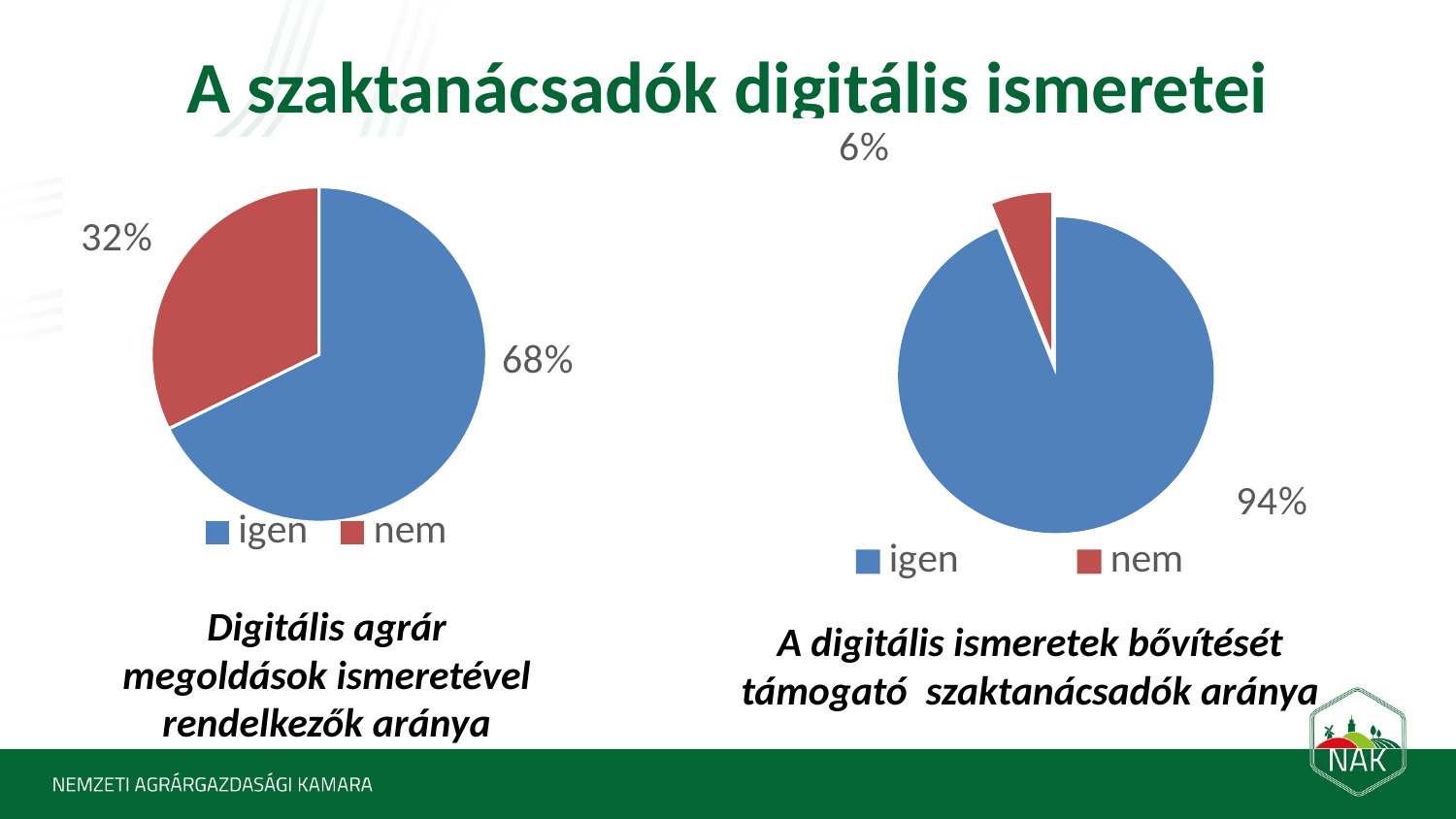
What colour represents 'nem' in the legends of both charts? red In the left pie chart, which category has the largest slice? igen What type of chart is used on the left side of the slide? pie chart In the right pie chart, which category has the smallest slice? nem In the left pie chart (Digitális agrár megoldások ismeretével rendelkezők aránya), what share is labelled for 'igen'? 68% In the left pie chart, what is the difference in percentage points between 'igen' and 'nem'? 36 In the left pie chart (Digitális agrár megoldások ismeretével rendelkezők aránya), what share is labelled for 'nem'? 32% In the right pie chart (A digitális ismeretek bővítését támogató szaktanácsadók aránya), what share is labelled for 'igen'? 94% In the right pie chart, what is the difference in percentage points between 'igen' and 'nem'? 88 In the right pie chart (A digitális ismeretek bővítését támogató szaktanácsadók aránya), what share is labelled for 'nem'? 6% Is the 'nem' share larger in the left pie chart or in the right pie chart? left pie chart How many slices does the right pie chart have? 2